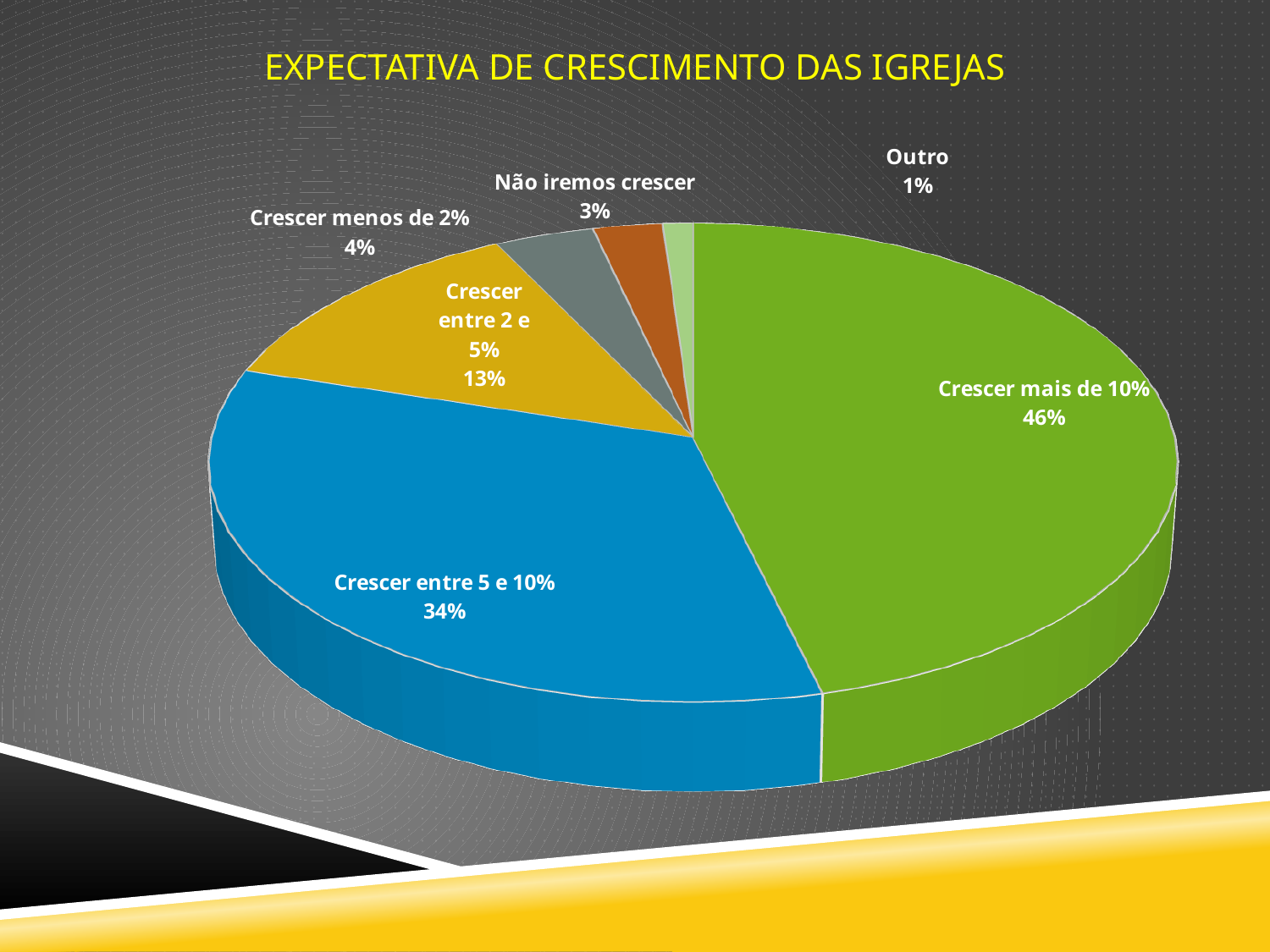
What share of the pie is 'Não iremos crescer'? 3% What share of the pie is 'Crescer entre 5 e 10%'? 34% What is the title of the chart? EXPECTATIVA DE CRESCIMENTO DAS IGREJAS How many slices does the pie chart have? 6 What kind of chart is shown on the slide? Pie chart What share of the pie is 'Crescer mais de 10%'? 46% What is the difference in percentage points between 'Crescer mais de 10%' and 'Crescer entre 5 e 10%'? 12 Which category has the smallest slice of the pie? Outro Which category has the largest slice of the pie? Crescer mais de 10% What colour is the 'Crescer entre 5 e 10%' slice? Blue Which is larger, 'Crescer menos de 2%' or 'Não iremos crescer'? Crescer menos de 2%